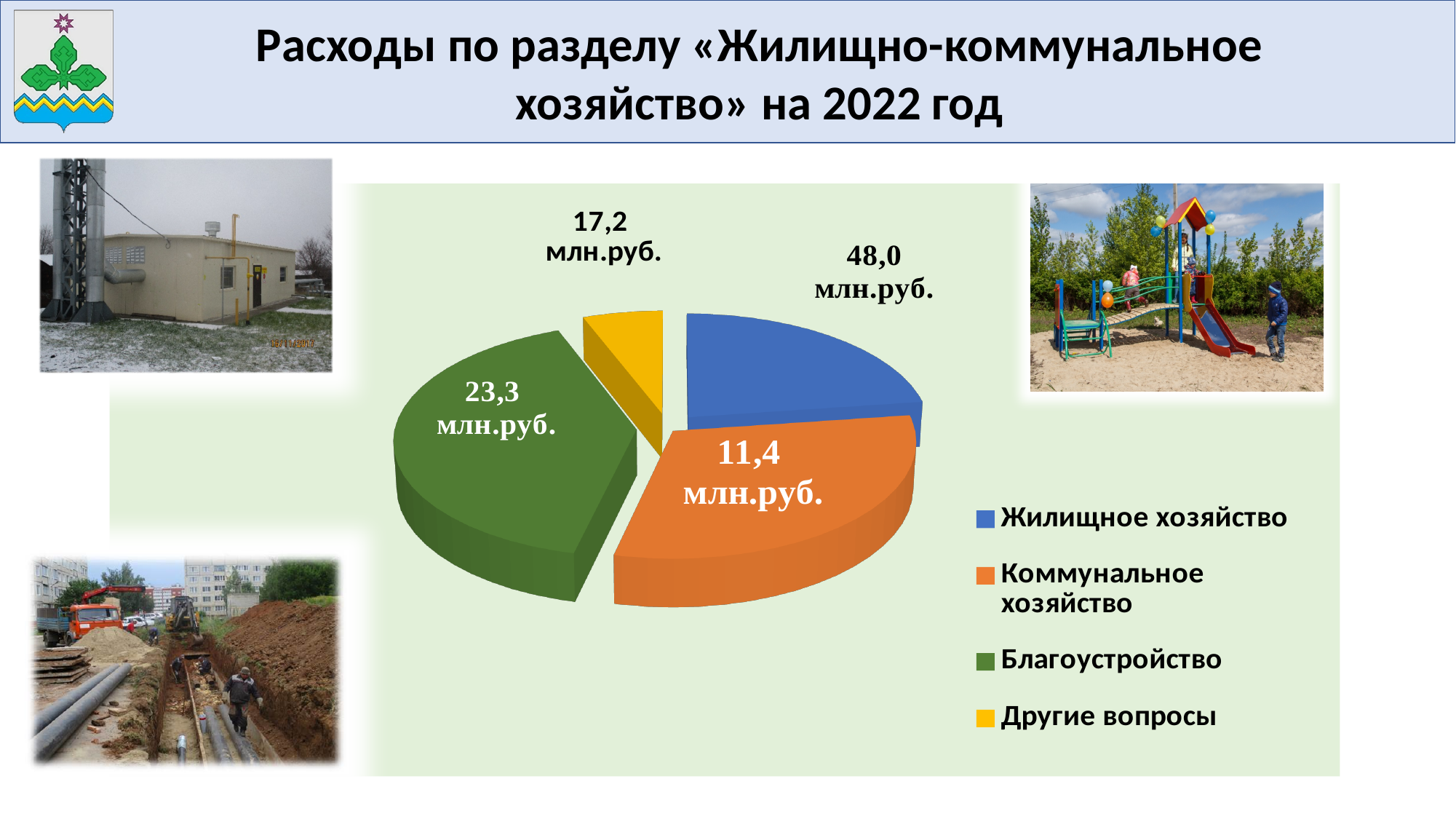
What is the smallest value printed as a data label on the pie chart? 11,4 млн.руб. How many entries does the legend of the pie chart list? 4 Which category has the smallest slice in the pie chart? Другие вопросы What kind of chart is shown on the slide? pie chart How many slices does the pie chart have? 4 Which colour represents Благоустройство in the pie chart legend? green Which slice is larger: Жилищное хозяйство or Другие вопросы? Жилищное хозяйство What is the difference between the largest and smallest values printed on the pie chart? 36,6 млн.руб. What is the largest value printed as a data label on the pie chart? 48,0 млн.руб. What is the sum of the four values printed on the pie chart? 99,9 млн.руб. What is the title of the slide containing the pie chart? Расходы по разделу «Жилищно-коммунальное хозяйство» на 2022 год